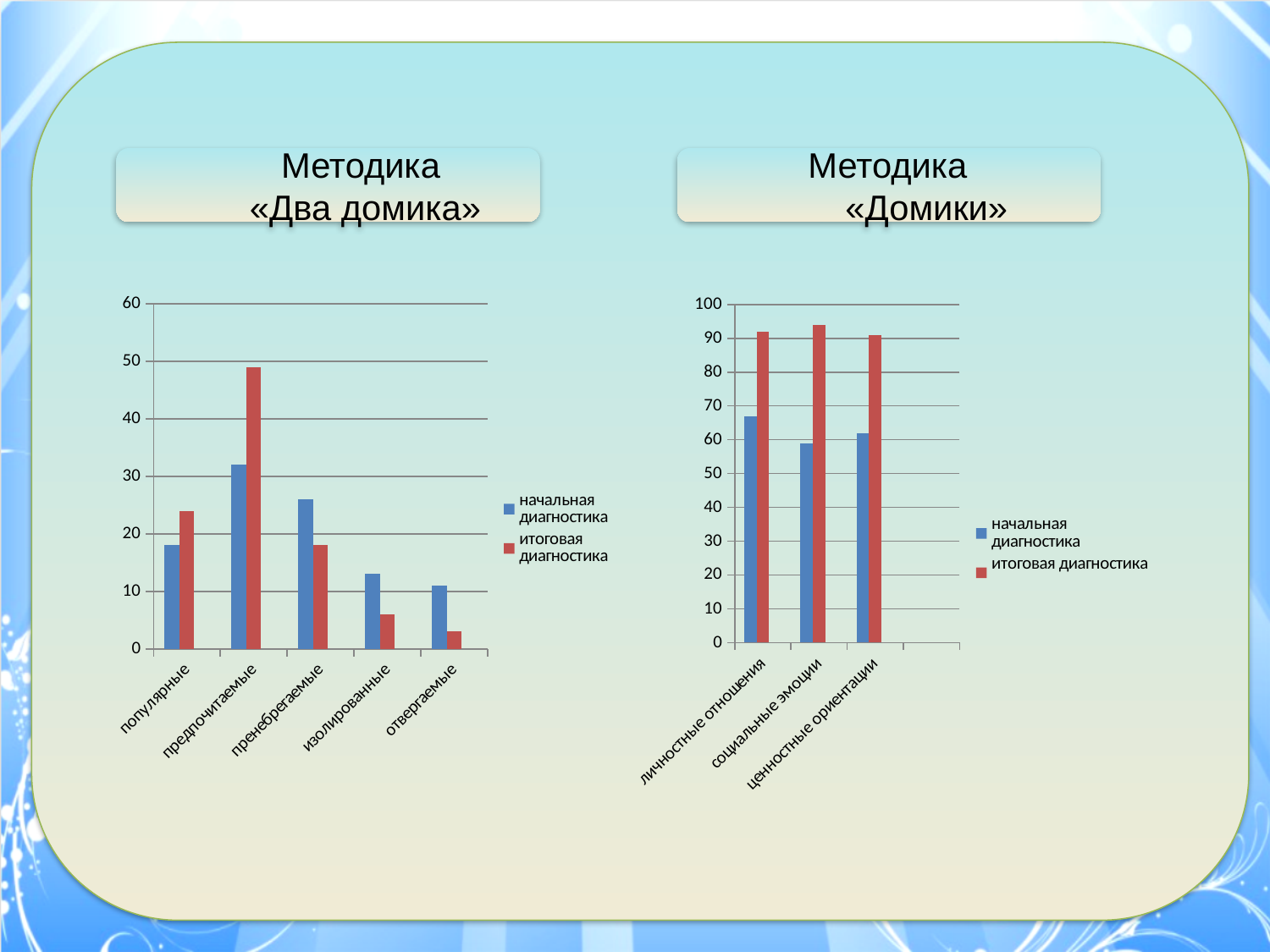
In the «Методика «Два домика»» chart, how many series does the legend list? 2 In the «Методика «Домики»» chart, how many categories are shown on the x axis? 3 In the «Методика «Два домика»» chart, is the value of итоговая диагностика for предпочитаемые greater or less than 40? greater In the «Методика «Домики»» chart, is the value of начальная диагностика for личностные отношения greater or less than 60? greater In the «Методика «Два домика»» chart, which category has the highest value for итоговая диагностика? предпочитаемые In the «Методика «Два домика»» chart, is the value of начальная диагностика for отвергаемые greater or less than 20? less In the «Методика «Домики»» chart, what colour are the bars for итоговая диагностика? red In the «Методика «Два домика»» chart, how many categories are shown on the x axis? 5 In the «Методика «Два домика»» chart, for популярные, which series has the larger value: начальная диагностика or итоговая диагностика? итоговая диагностика What kind of chart is the «Методика «Два домика»» chart on the left? bar chart In the «Методика «Домики»» chart, for социальные эмоции, which series has the larger value: начальная диагностика or итоговая диагностика? итоговая диагностика In the «Методика «Два домика»» chart, which category has the lowest value for итоговая диагностика? отвергаемые